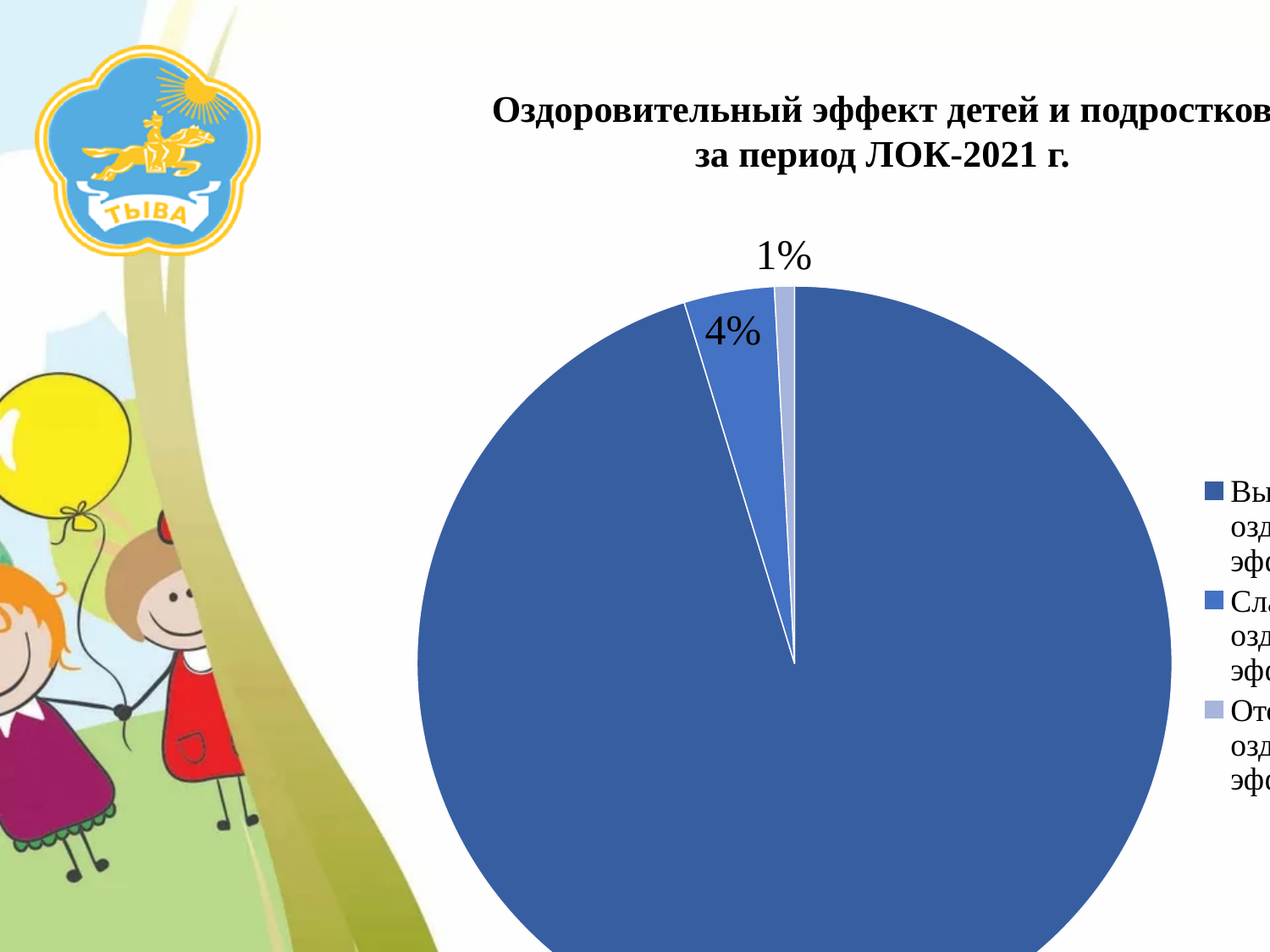
Which slice of the pie chart is the smallest? the light blue slice (1%) What kind of chart is shown on the slide? pie chart How many slices does the pie chart have? 3 What percentage is printed on the light blue slice of the pie chart? 1% Is the share of the dark blue slice of the pie chart greater or less than 50%? greater Which is larger, the medium blue slice or the light blue slice of the pie chart? the medium blue slice What percentage is printed on the medium blue slice of the pie chart? 4% Which period is named in the title of the pie chart? ЛОК-2021 г. Which slice of the pie chart is the largest? the dark blue slice What is the title of the pie chart? Оздоровительный эффект детей и подростков за период ЛОК-2021 г. How many entries does the legend of the pie chart list? 3 What is the difference in percentage points between the medium blue slice (4%) and the light blue slice (1%)? 3